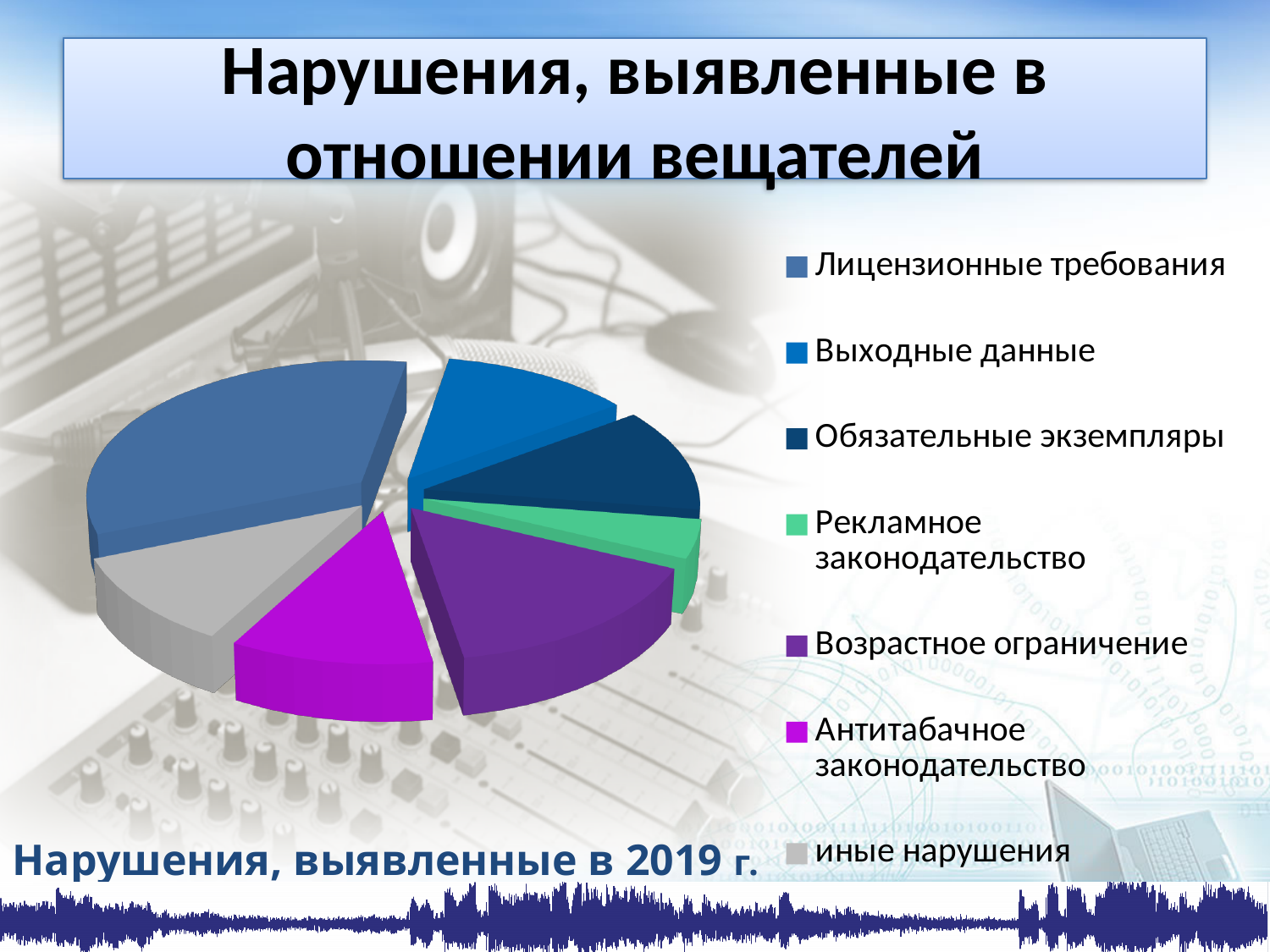
What kind of chart is shown on the slide? pie chart How many categories (slices) does the pie chart have? 7 Which slice is larger: Обязательные экземпляры or Рекламное законодательство? Обязательные экземпляры Which slice is larger: Лицензионные требования or Выходные данные? Лицензионные требования Which category has the largest slice in the pie chart? Лицензионные требования What colour represents Антитабачное законодательство in the pie chart legend? magenta Which slice is larger: Возрастное ограничение or Рекламное законодательство? Возрастное ограничение What is the title of the slide containing the pie chart? Нарушения, выявленные в отношении вещателей Which category has the smallest slice in the pie chart? Рекламное законодательство